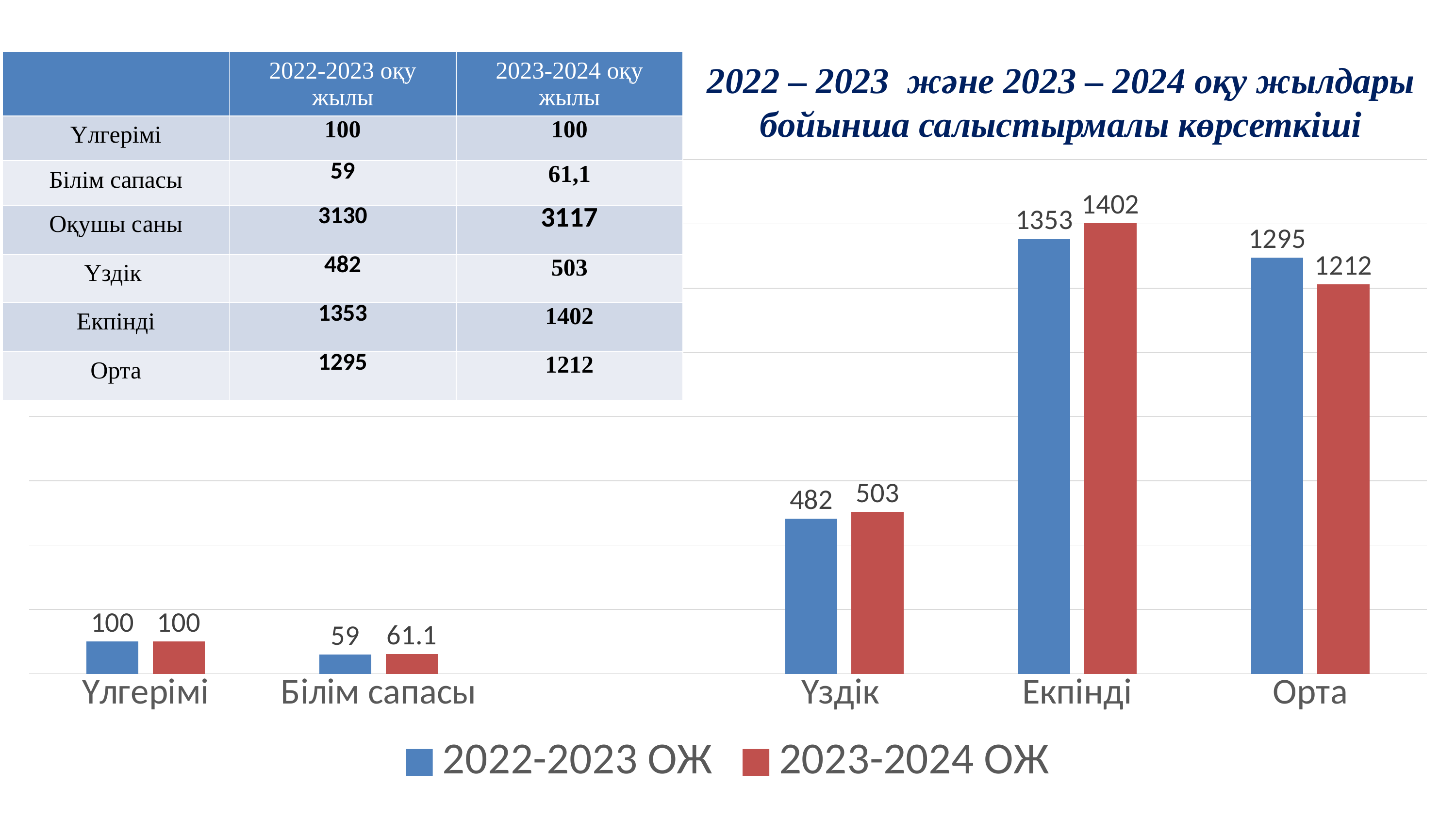
What is the difference between the 2022-2023 ОЖ and 2023-2024 ОЖ values for Орта? 83 What is the difference between the 2023-2024 ОЖ and 2022-2023 ОЖ values for Екпінді? 49 For Үздік, which series has the larger value, 2022-2023 ОЖ or 2023-2024 ОЖ? 2023-2024 ОЖ What is the value for Үздік in the 2022-2023 ОЖ series? 482 Which labelled category has the highest value in the 2023-2024 ОЖ series? Екпінді What kind of chart is shown on the slide? bar chart How many series does the chart legend list? 2 What is the value for Орта in the 2022-2023 ОЖ series? 1295 Which colour represents the 2023-2024 ОЖ series in the chart? red What is the value for Екпінді in the 2023-2024 ОЖ series? 1402 Which labelled category has the lowest value in the 2022-2023 ОЖ series? Білім сапасы What is the value for Білім сапасы in the 2023-2024 ОЖ series? 61.1